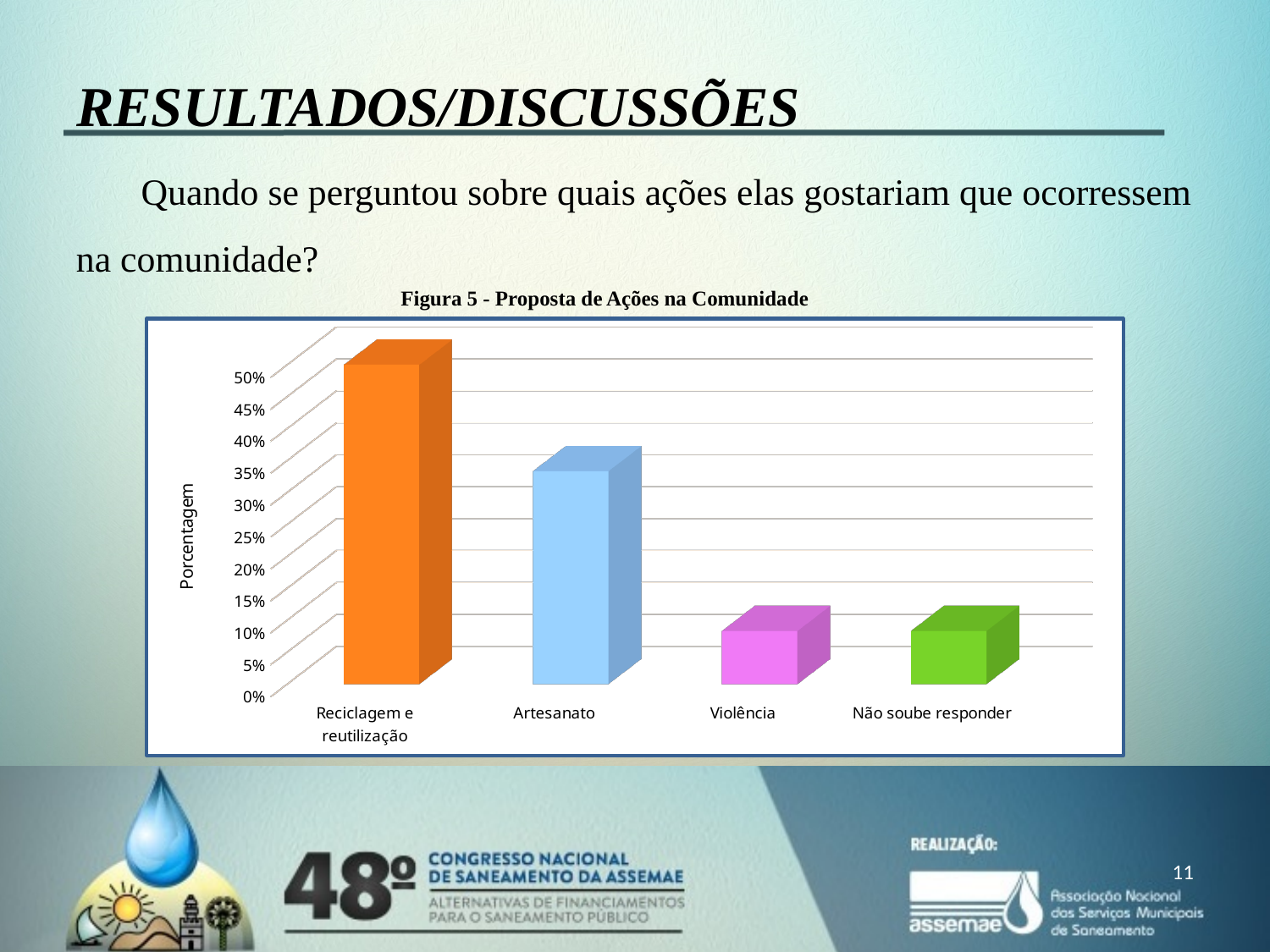
Is the value for Não soube responder greater or less than 15%? less What is the label on the vertical axis of the chart? Porcentagem What kind of chart is shown on the slide? bar chart Which category has the highest value in the chart? Reciclagem e reutilização Is the value for Artesanato greater or less than 40%? less Is the value for Reciclagem e reutilização greater or less than 40%? greater What is the title of the chart? Figura 5 - Proposta de Ações na Comunidade Which is larger, the value for Artesanato or the value for Violência? Artesanato How many categories are shown on the x axis of the chart? 4 Which is larger, the value for Reciclagem e reutilização or the value for Artesanato? Reciclagem e reutilização